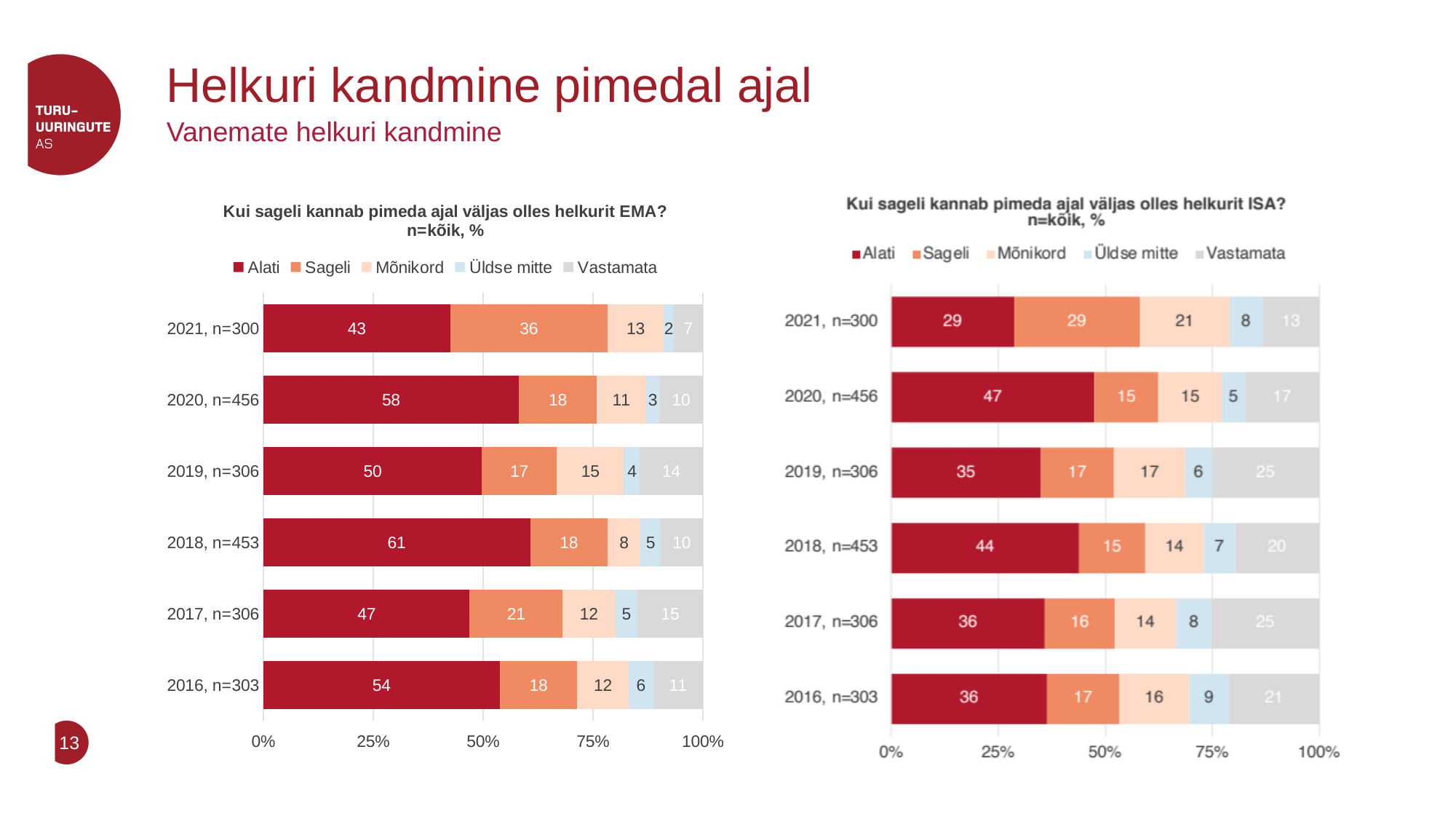
In the EMA chart (left), what is the value for "Üldse mitte" in 2016, n=303? 6 How many series does the legend of the ISA chart (right) list? 5 In the ISA chart (right), what is the value for "Vastamata" in 2019, n=306? 25 In the ISA chart (right), what is the total of the "Alati" and "Sageli" segments for 2021, n=300? 58 What kind of chart is the EMA chart (left)? Stacked bar chart In the ISA chart (right), which is larger: the "Sageli" value for 2021, n=300 or for 2020, n=456? 2021, n=300 What is the title of the chart on the right? Kui sageli kannab pimeda ajal väljas olles helkurit ISA? n=kõik, % In the ISA chart (right), which year has the lowest "Alati" value? 2021, n=300 In the EMA chart (left), which year has the highest "Alati" value? 2018, n=453 In the EMA chart (left), what is the value for "Alati" in 2021, n=300? 43 In the EMA chart (left), what is the difference between the "Alati" values for 2020, n=456 and 2021, n=300? 15 How many year categories does the EMA chart (left) show? 6